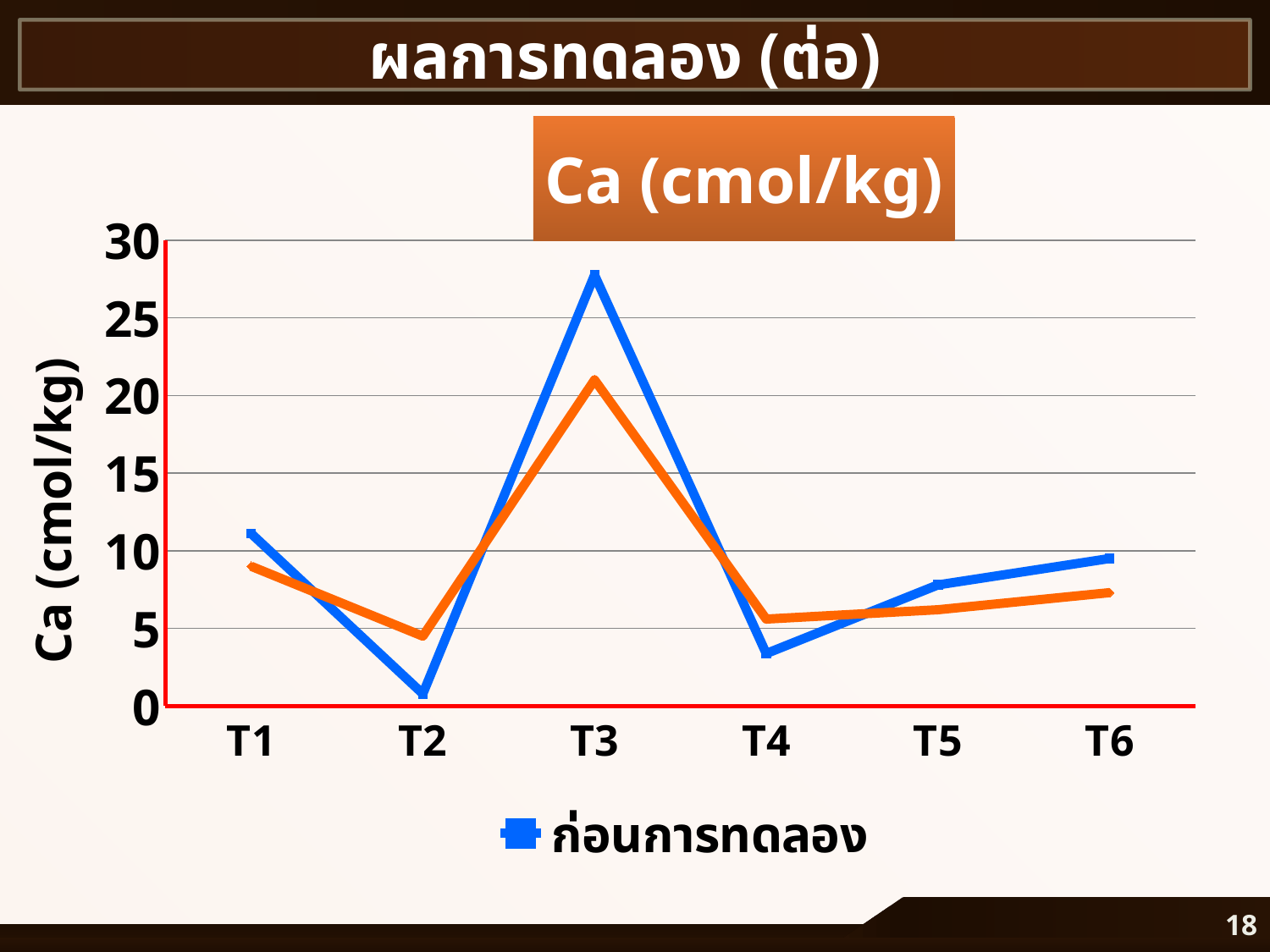
What kind of chart is shown on the slide? line chart Is the value of the blue line (ก่อนการทดลอง) at T3 greater or less than 25? greater Does the blue line (ก่อนการทดลอง) rise or fall from T3 to T4? fall What is the legend entry for the blue line? ก่อนการทดลอง How many categories are shown on the x axis? 6 Is the value of the blue line (ก่อนการทดลอง) at T2 greater or less than 5? less At T3, which line has the higher value, the blue line or the orange line? the blue line At which category does the orange line reach its highest value? T3 What is the title of the chart? Ca (cmol/kg) At which category does the blue line (ก่อนการทดลอง) reach its lowest value? T2 How many entries does the legend list? 1 At which category does the blue line (ก่อนการทดลอง) reach its highest value? T3